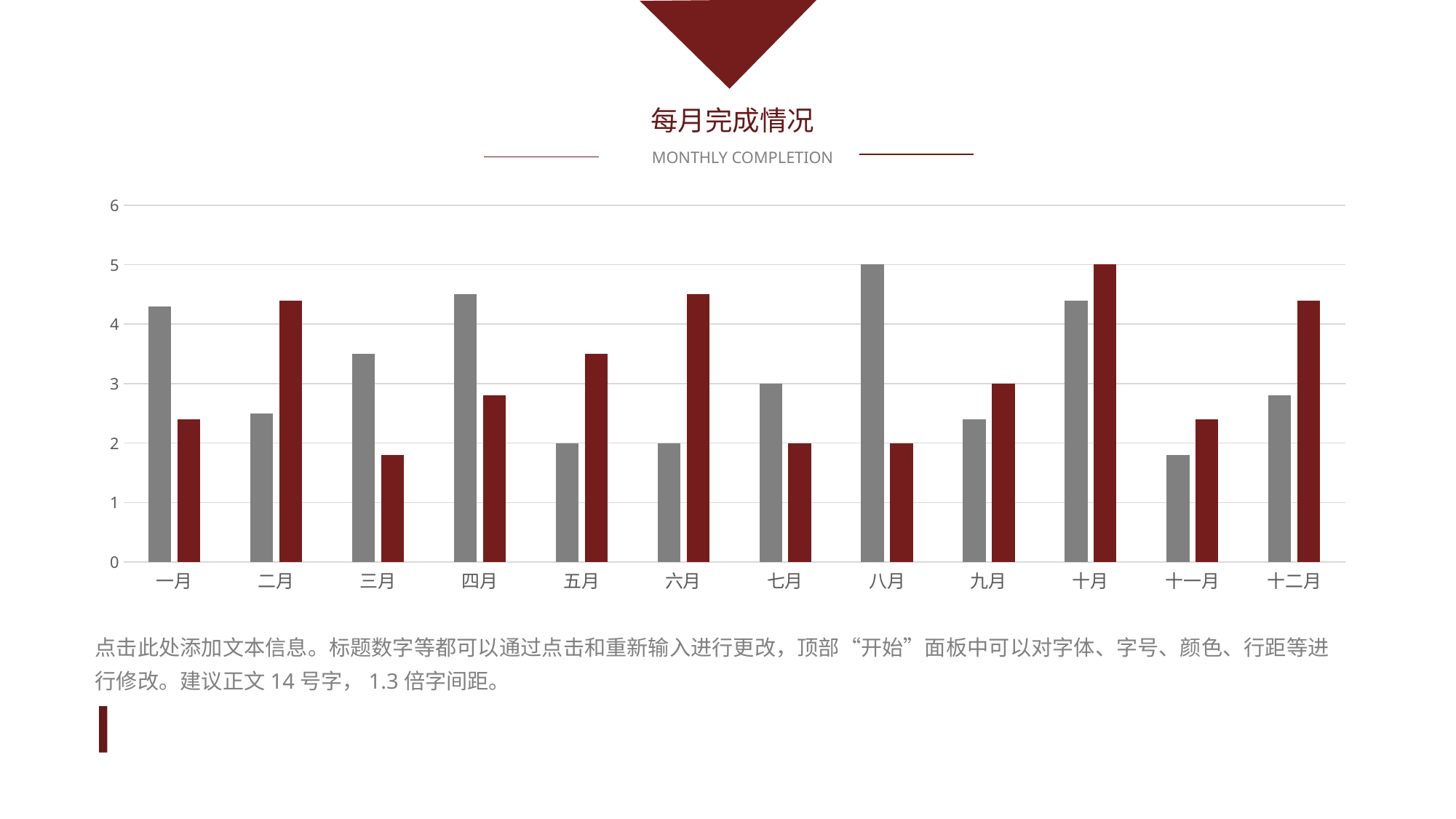
In which month is the dark red bar the highest? 十月 What is the difference between the gray bar and the dark red bar for 八月? 3 What is the value of the dark red bar for 十月? 5 How many months are shown on the x axis of the chart? 12 What kind of chart is shown on the slide? Bar chart For 二月, which bar is larger, the gray bar or the dark red bar? The dark red bar In which month is the gray bar the highest? 八月 Is the dark red bar for 一月 greater or less than 3? less Is the gray bar for 一月 greater or less than 4? greater What is the title of the chart on the slide? 每月完成情况 What is the value of the gray bar for 八月? 5 What is the value of the gray bar for 七月? 3